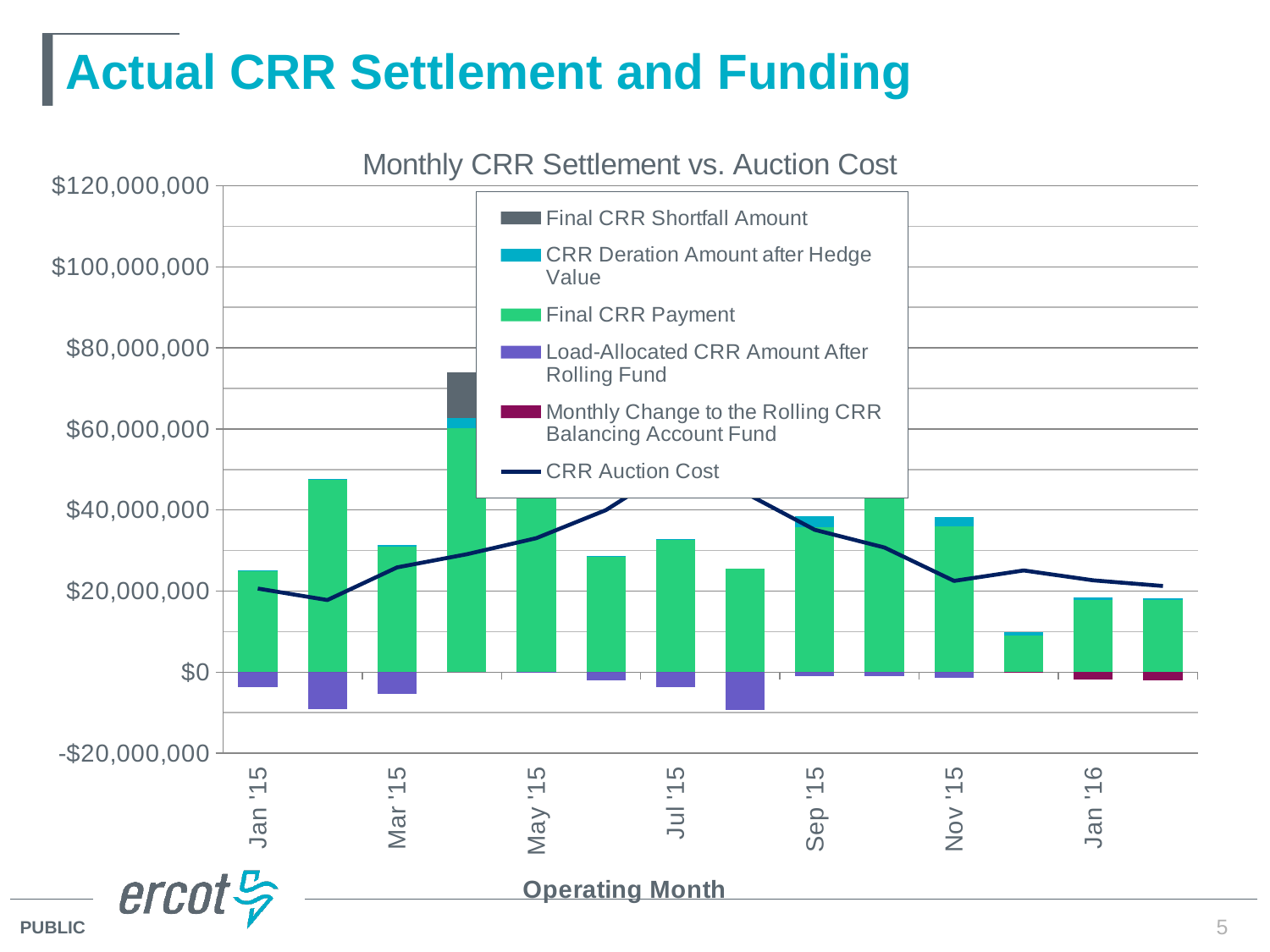
What is the title of the chart? Monthly CRR Settlement vs. Auction Cost Is the Final CRR Payment for Jan '15 greater or less than $20,000,000? greater What kind of chart is shown on the slide? Stacked bar chart with a line Which has the larger Final CRR Payment, Jan '15 or Mar '15? Mar '15 Does the CRR Auction Cost line rise or fall from Sep '15 to Jan '16? fall Among the labeled months, which has the lowest Final CRR Payment? Jan '16 Is the Final CRR Payment for May '15 greater or less than $60,000,000? less How many series does the legend list? 6 Is the CRR Auction Cost for May '15 greater or less than $40,000,000? less Among the labeled months, which has the highest Final CRR Payment? May '15 How many monthly bars are plotted on the chart? 14 How many month labels are shown on the x axis? 7